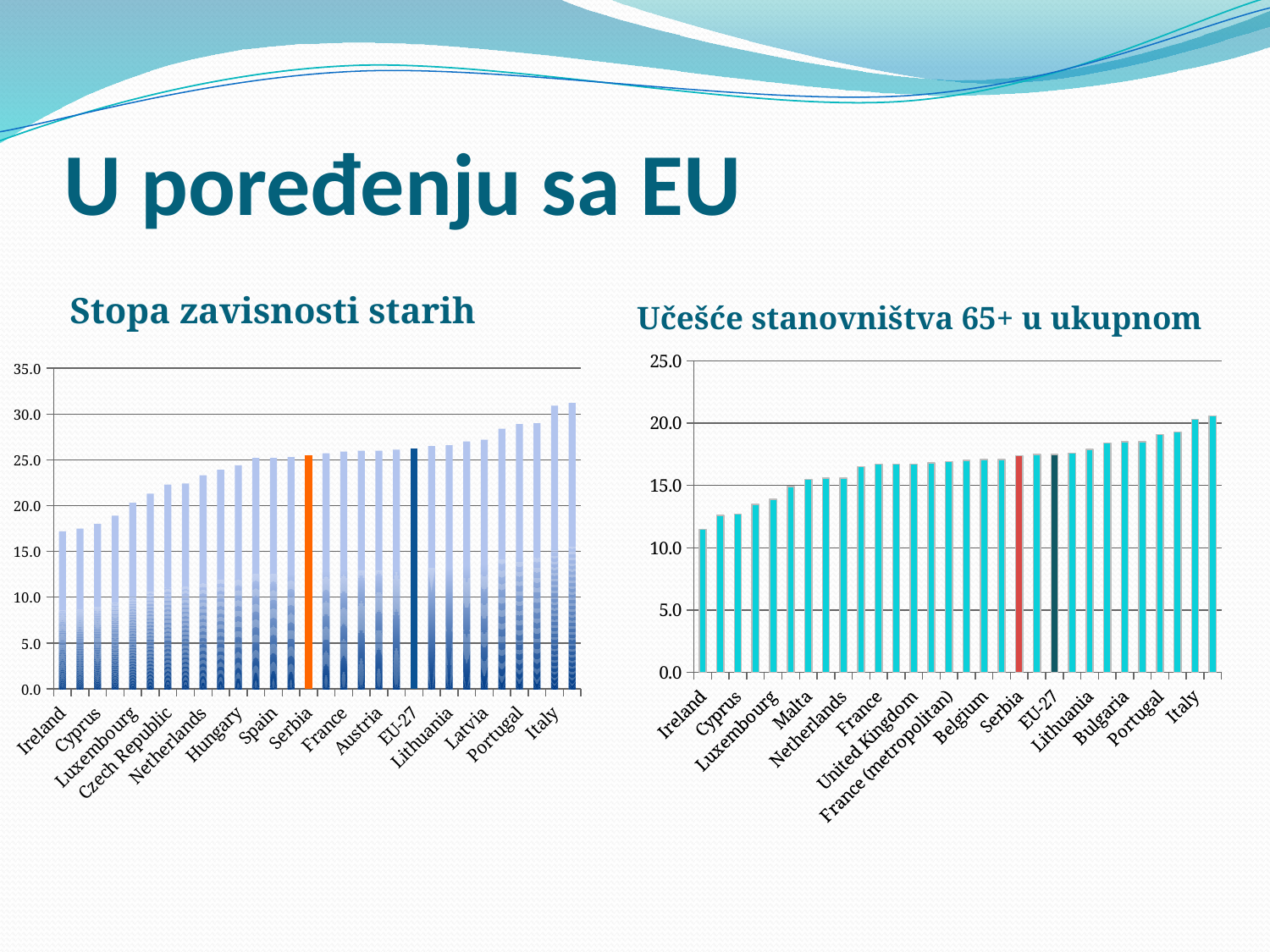
In the 'Učešće stanovništva 65+ u ukupnom' chart, is the value for Ireland greater or less than 10.0? greater In the 'Stopa zavisnosti starih' chart, is the value for Serbia greater or less than 20.0? greater In the 'Učešće stanovništva 65+ u ukupnom' chart, which country has the lowest value? Ireland In the 'Stopa zavisnosti starih' chart, which country has the lowest value? Ireland In the 'Stopa zavisnosti starih' chart, do the values rise or fall from left to right along the x axis? rise In the 'Učešće stanovništva 65+ u ukupnom' chart, which is larger, the value for Italy or the value for Cyprus? Italy In the 'Stopa zavisnosti starih' chart, is the value for Italy greater or less than 30.0? greater In the 'Stopa zavisnosti starih' chart, what colour is the bar for Serbia? orange What kind of chart is the 'Stopa zavisnosti starih' chart? bar chart